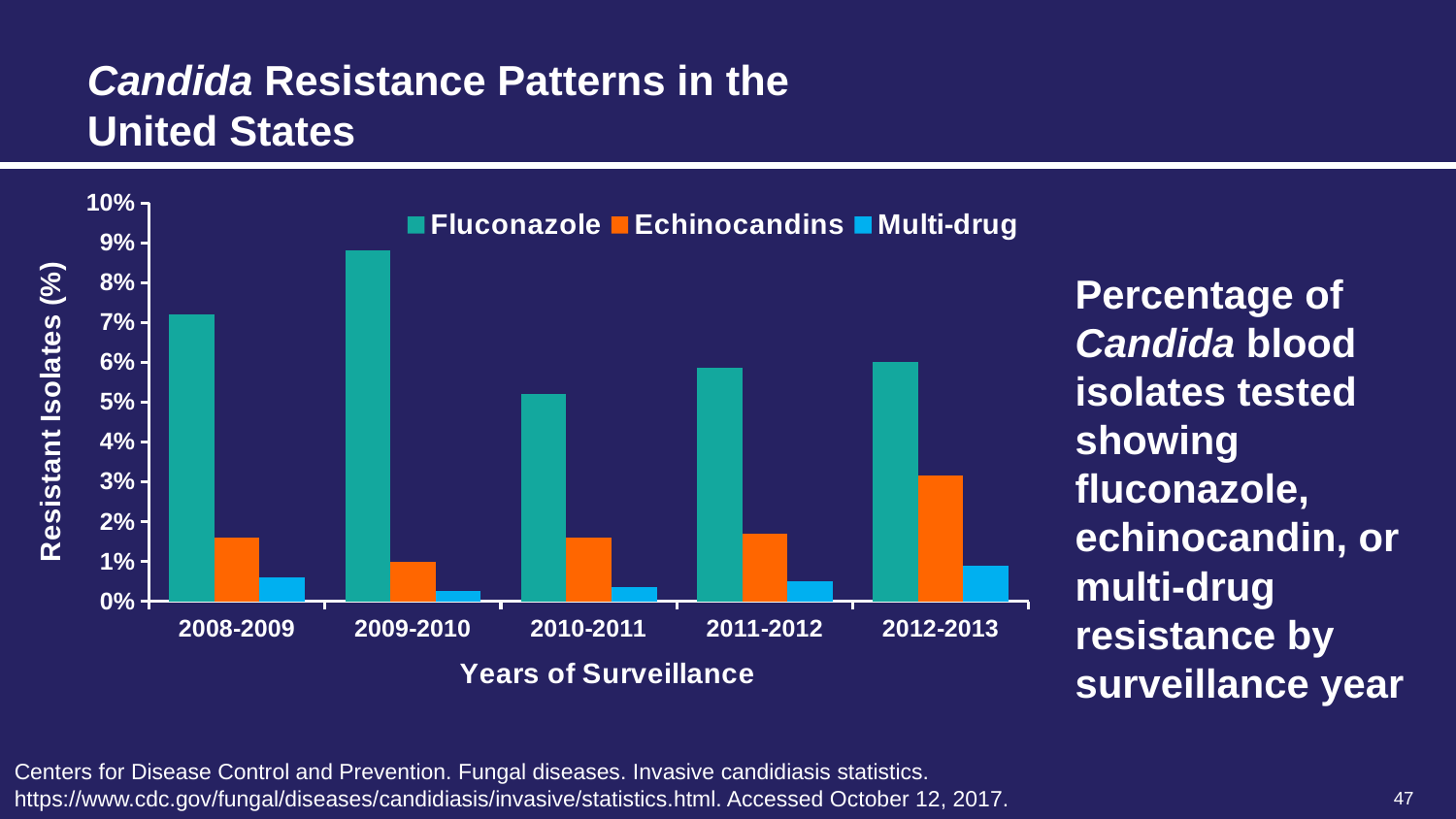
How many surveillance-year categories are shown on the x axis? 5 Is the Fluconazole value for 2009-2010 greater or less than 8%? greater Which is larger in 2012-2013, the Fluconazole value or the Echinocandins value? Fluconazole In which surveillance year is the Fluconazole resistance lowest? 2010-2011 In which surveillance year is the Multi-drug resistance highest? 2012-2013 In which surveillance year is the Fluconazole resistance highest? 2009-2010 Is the Echinocandins value for 2012-2013 greater or less than 2%? greater What kind of chart is shown on the slide? bar chart In which surveillance year is the Echinocandins resistance lowest? 2009-2010 In which surveillance year is the Echinocandins resistance highest? 2012-2013 What is the label of the y axis? Resistant Isolates (%) How many series does the legend list? 3